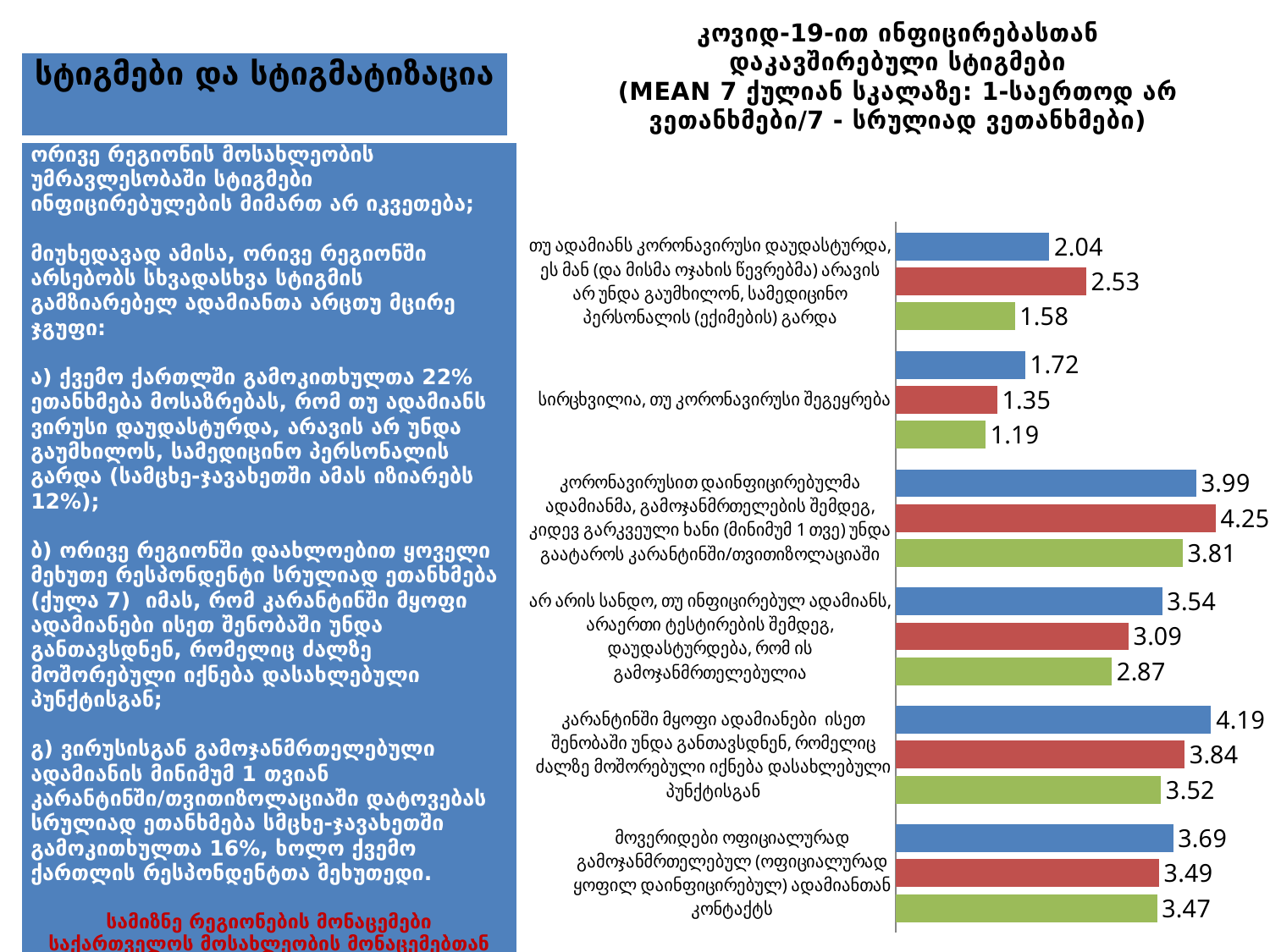
According to the chart title, what scale are the mean values measured on? 7-point scale (1 – strongly disagree / 7 – strongly agree) Which statement has the highest blue-bar value? კარანტინში მყოფი ადამიანები ისეთ შენობაში უნდა განთავსდნენ, რომელიც ძალზე მოშორებული იქნება დასახლებული პუნქტისგან What kind of chart is shown on the slide? bar chart What is the value of the red bar for the statement "კორონავირუსით დაინფიცირებულმა ადამიანმა, გამოჯანმრთელების შემდეგ, კიდევ გარკვეული ხანი (მინიმუმ 1 თვე) უნდა გაატაროს კარანტინში/თვითიზოლაციაში"? 4.25 What is the value of the green bar for the statement "მოვერიდები ოფიციალურად გამოჯანმრთელებულ (ოფიციალურად ყოფილ დაინფიცირებულ) ადამიანთან კონტაქტს"? 3.47 What is the difference between the blue bar (4.19) and the green bar (3.52) for the statement "კარანტინში მყოფი ადამიანები ისეთ შენობაში უნდა განთავსდნენ..."? 0.67 Which statement has the lowest green-bar value? სირცხვილია, თუ კორონავირუსი შეგეყრება What is the value of the blue bar for the statement "სირცხვილია, თუ კორონავირუსი შეგეყრება"? 1.72 How many bars are shown for each statement in the chart? 3 How many categories (statements) are plotted in the chart? 6 What is the difference between the red bar (3.09) and the green bar (2.87) for the statement "არ არის სანდო, თუ ინფიცირებულ ადამიანს... გამოჯანმრთელებულია"? 0.22 For the statement "თუ ადამიანს კორონავირუსი დაუდასტურდა... სამედიცინო პერსონალის (ექიმების) გარდა", which bar is larger, the blue one or the red one? red